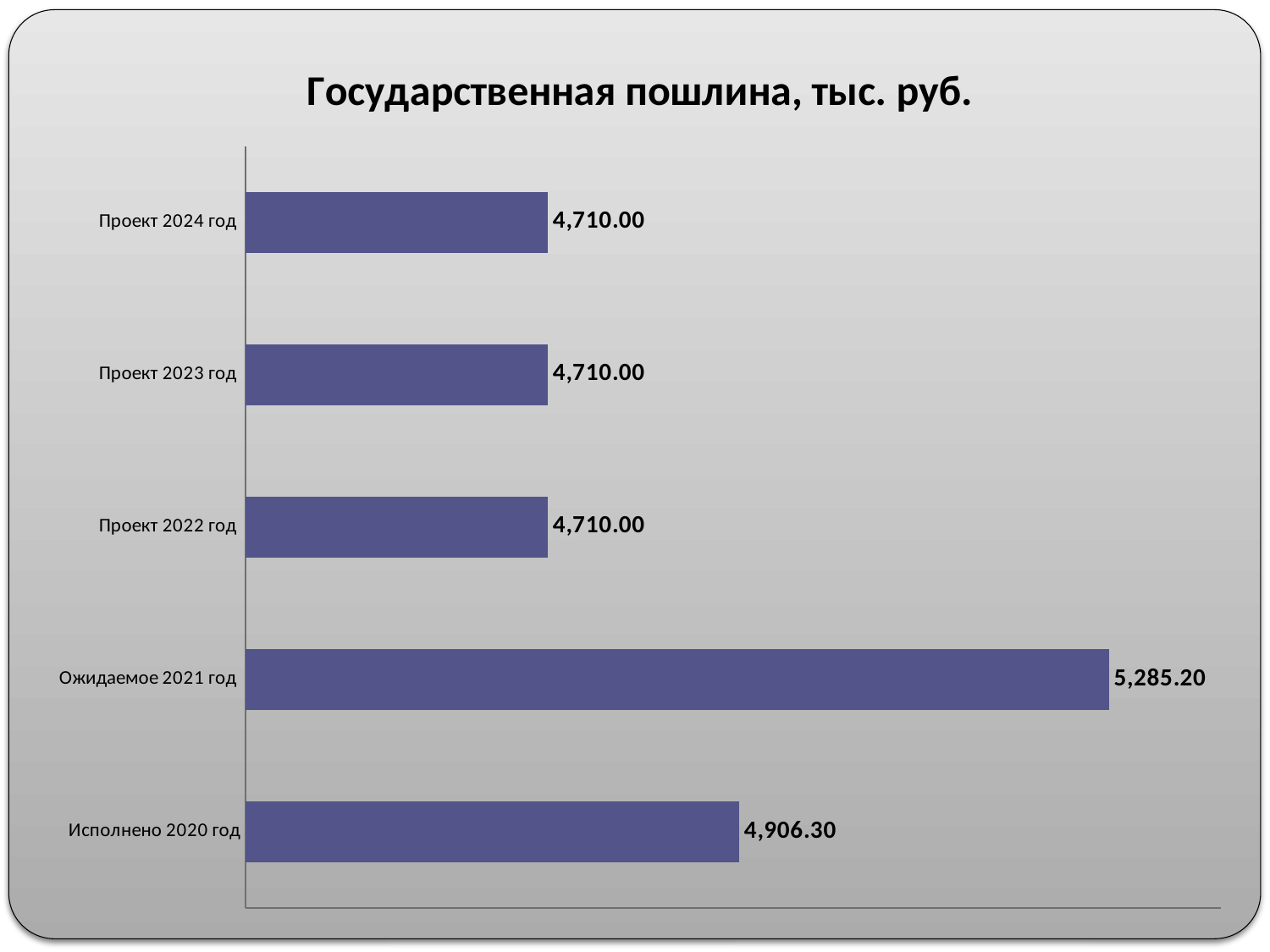
Which category has the highest value? Ожидаемое 2021 год How many categories are shown in the chart? 5 What is the value for Ожидаемое 2021 год? 5,285.20 Which is larger, the value for Ожидаемое 2021 год or the value for Проект 2022 год? Ожидаемое 2021 год Which is larger, the value for Исполнено 2020 год or the value for Проект 2024 год? Исполнено 2020 год What is the value for Проект 2024 год? 4,710.00 What kind of chart is shown on the slide? Bar chart What is the difference between the values for Исполнено 2020 год and Проект 2023 год? 196.30 What is the value for Проект 2022 год? 4,710.00 What is the difference between the values for Ожидаемое 2021 год and Исполнено 2020 год? 378.90 What is the title of the chart? Государственная пошлина, тыс. руб. What is the value for Исполнено 2020 год? 4,906.30